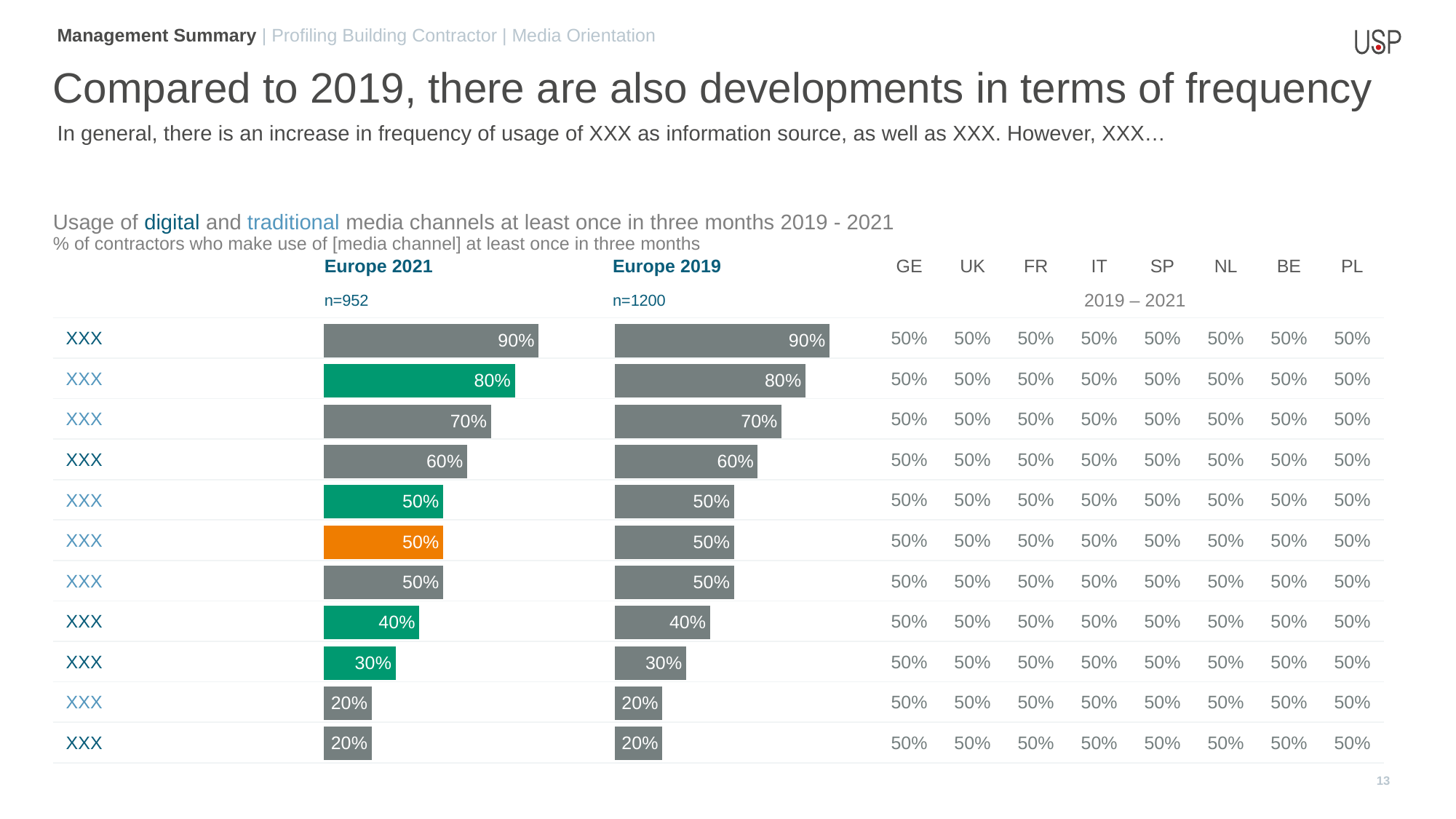
What is the sample size (n) given for the Europe 2019 chart? n=1200 How many bars does the Europe 2021 chart contain? 11 What is the highest value shown in the Europe 2021 chart? 90% In the Europe 2021 chart, do the bar values rise or fall from the top row to the bottom row? fall In the Europe 2021 chart, what colour is the sixth bar from the top? orange What kind of chart is the Europe 2021 chart? bar chart What is the lowest value shown in the Europe 2019 chart? 20% What is the sample size (n) given for the Europe 2021 chart? n=952 In the Europe 2019 chart, what is the value of the top bar? 90% In the Europe 2021 chart, how many bars are coloured green? 4 In the Europe 2021 chart, what is the difference between the highest and the lowest bar values? 70 percentage points In the Europe 2021 chart, how many bars are labelled 50%? 3